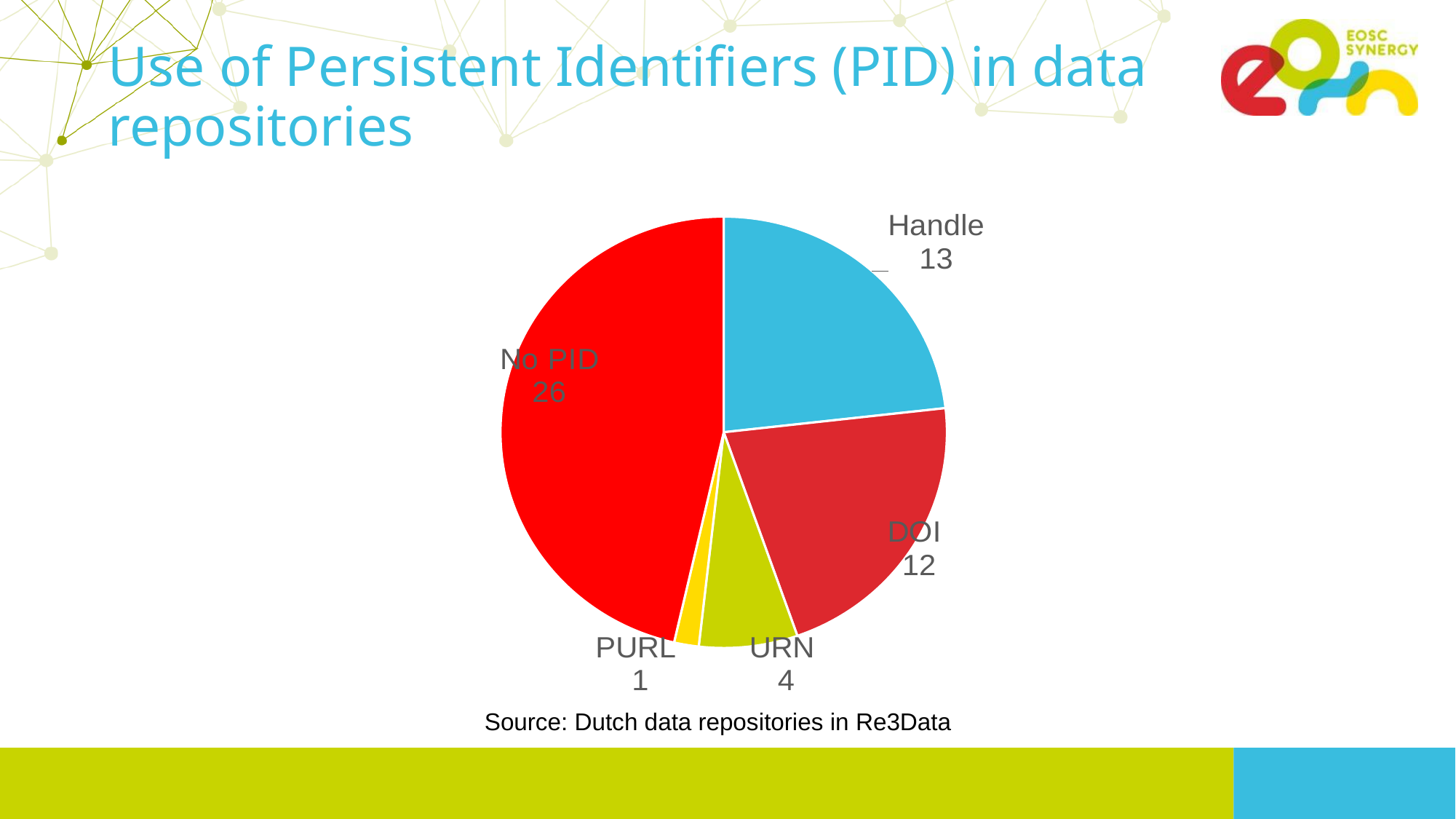
What is the value for URN in the pie chart? 4 What is the value for DOI in the pie chart? 12 What is the value for Handle in the pie chart? 13 What is the source cited below the pie chart? Dutch data repositories in Re3Data What kind of chart is shown on the slide? pie chart Which category has the smallest slice in the pie chart? PURL How many slices does the pie chart have? 5 What is the value for No PID in the pie chart? 26 Which category has the largest slice in the pie chart? No PID What is the value for PURL in the pie chart? 1 Which is larger, the value for URN or the value for PURL? URN What is the difference between the values for No PID and Handle? 13